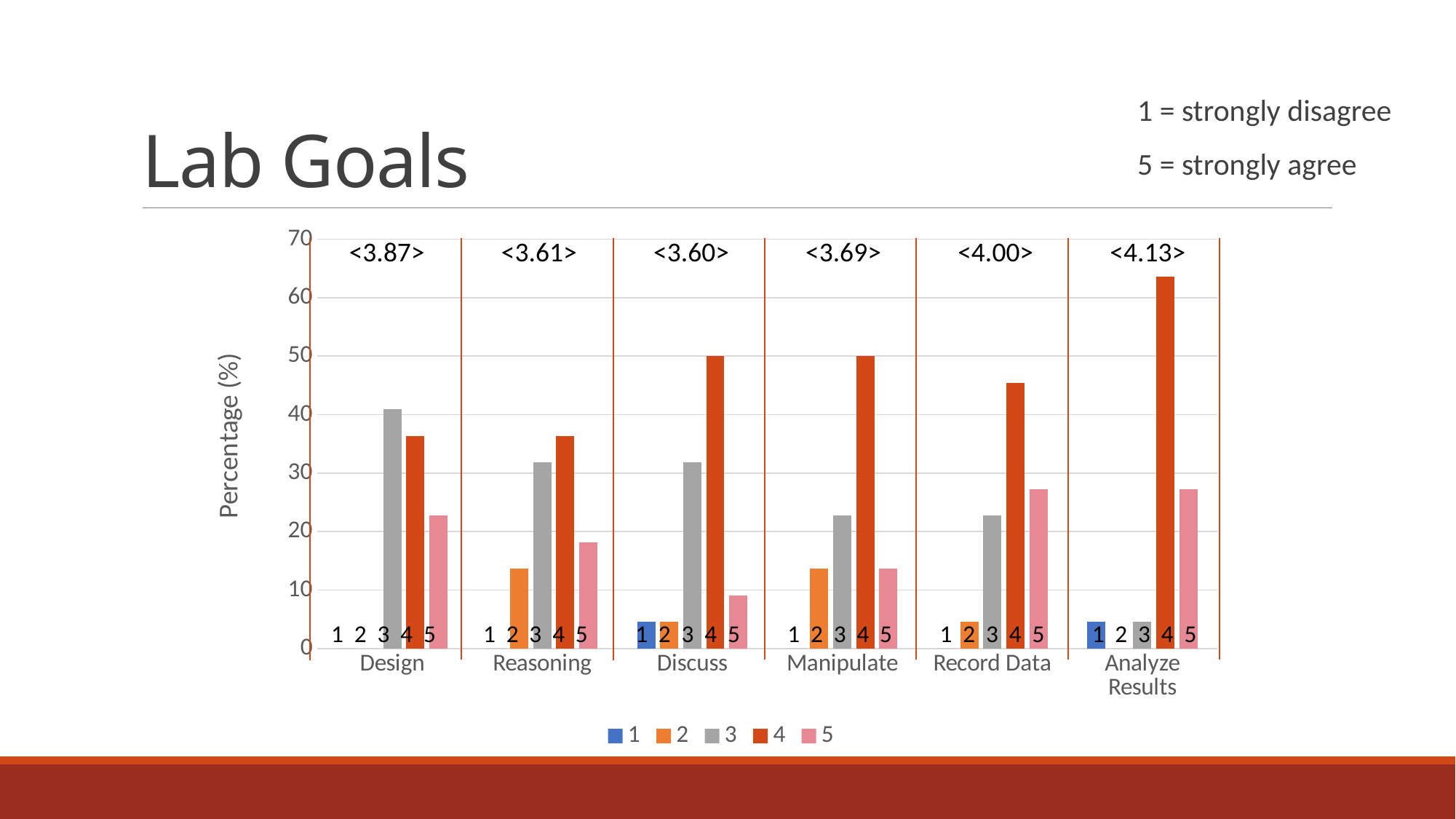
What is the label of the y axis? Percentage (%) What kind of chart is shown on the slide? bar chart How many series does the legend list? 5 Which category has the tallest bar for series 4? Analyze Results What is the mean value printed above the Design group? <3.87> Is the value for series 5 in Reasoning greater or less than 20? less Which category has the lowest printed mean value? Discuss Is the value for series 4 in Analyze Results greater or less than 60? greater What is the mean value printed above the Record Data group? <4.00> What is the difference between the printed mean values for Analyze Results and Discuss? 0.53 Which category has the highest printed mean value? Analyze Results How many categories are shown along the x axis? 6